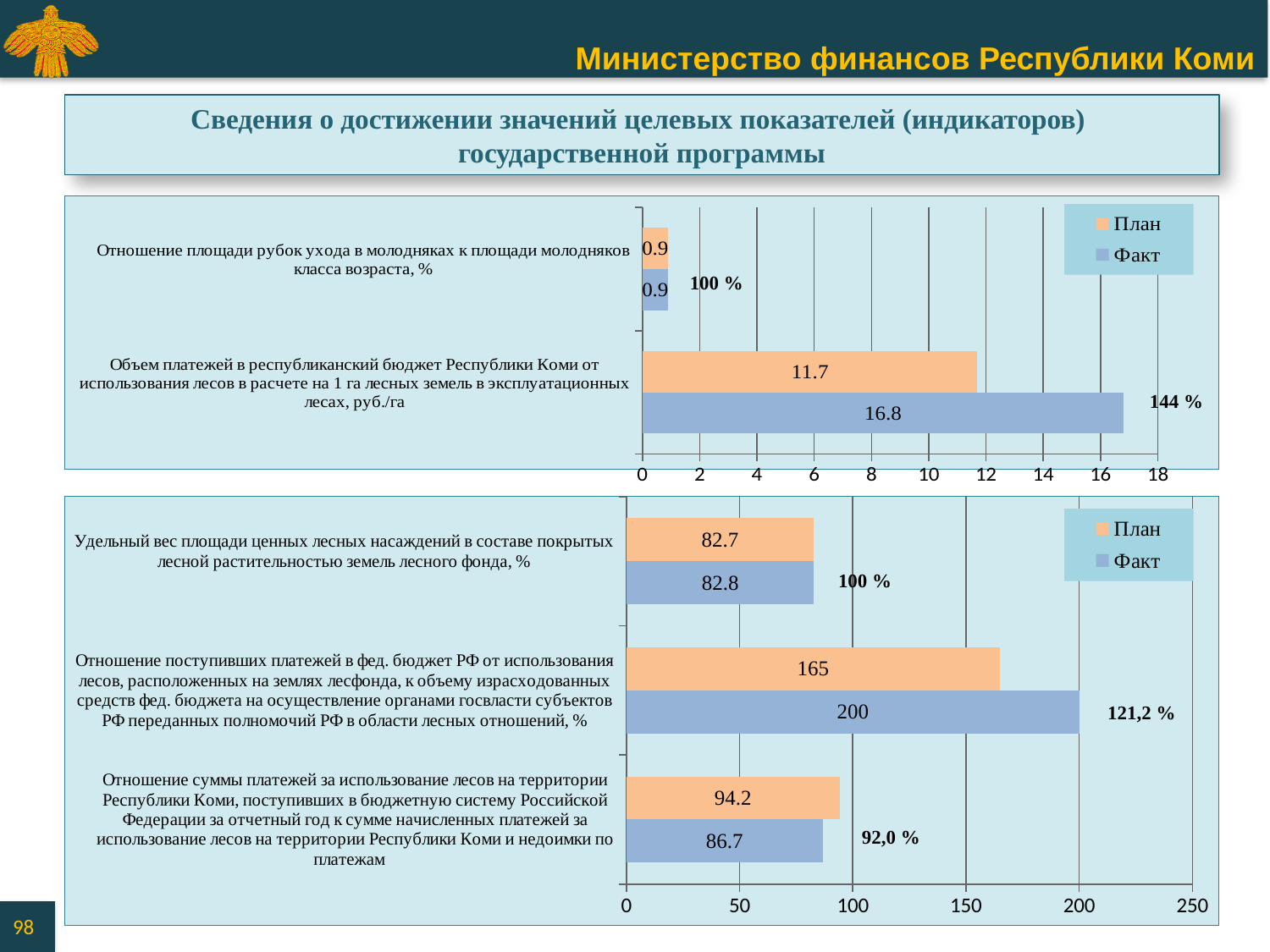
On the top chart, how many categories are plotted? 2 On the bottom chart, what is the План (plan) value for 'Отношение суммы платежей за использование лесов на территории Республики Коми, поступивших в бюджетную систему Российской Федерации за отчетный год...'? 94.2 On the bottom chart, what percentage label is shown next to the bars for 'Отношение суммы платежей за использование лесов на территории Республики Коми...'? 92,0 % On the top chart, what kind of chart is shown? Bar chart On the top chart, what is the difference between the Факт and План values for 'Объем платежей в республиканский бюджет Республики Коми от использования лесов в расчете на 1 га лесных земель в эксплуатационных лесах, руб./га'? 5.1 On the bottom chart, what is the difference between the План and Факт values for 'Отношение поступивших платежей в фед. бюджет РФ от использования лесов...'? 35 On the bottom chart, for 'Отношение суммы платежей за использование лесов на территории Республики Коми...', which is larger: the План value or the Факт value? План On the bottom chart, how many series does the legend list? 2 On the bottom chart, what is the Факт (fact) value for 'Отношение поступивших платежей в фед. бюджет РФ от использования лесов, расположенных на землях лесфонда, к объему израсходованных средств фед. бюджета...'? 200 On the top chart, what is the План (plan) value for 'Объем платежей в республиканский бюджет Республики Коми от использования лесов в расчете на 1 га лесных земель в эксплуатационных лесах, руб./га'? 11.7 On the top chart, what is the Факт (fact) value for 'Объем платежей в республиканский бюджет Республики Коми от использования лесов в расчете на 1 га лесных земель в эксплуатационных лесах, руб./га'? 16.8